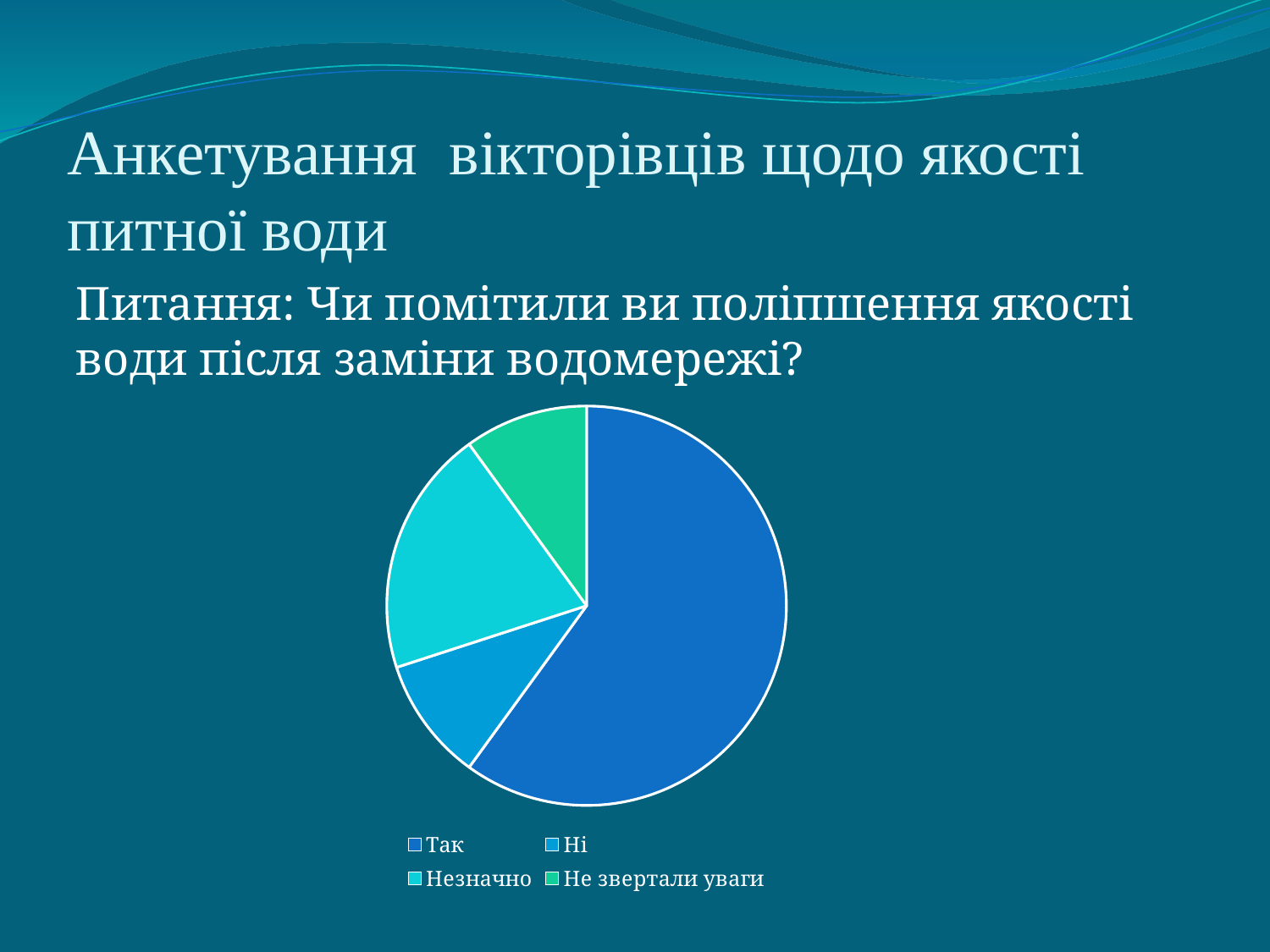
Which slice is larger, Так or Незначно? Так How many slices does the pie chart have? 4 Which slice is larger, Так or Не звертали уваги? Так Which legend entry is shown in green? Не звертали уваги What question is the pie chart answering, according to the text above it? Чи помітили ви поліпшення якості води після заміни водомережі? What kind of chart is shown on the slide? pie chart Which slice is larger, Незначно or Ні? Незначно Which category has the largest slice of the pie chart? Так How many entries does the legend of the pie chart list? 4